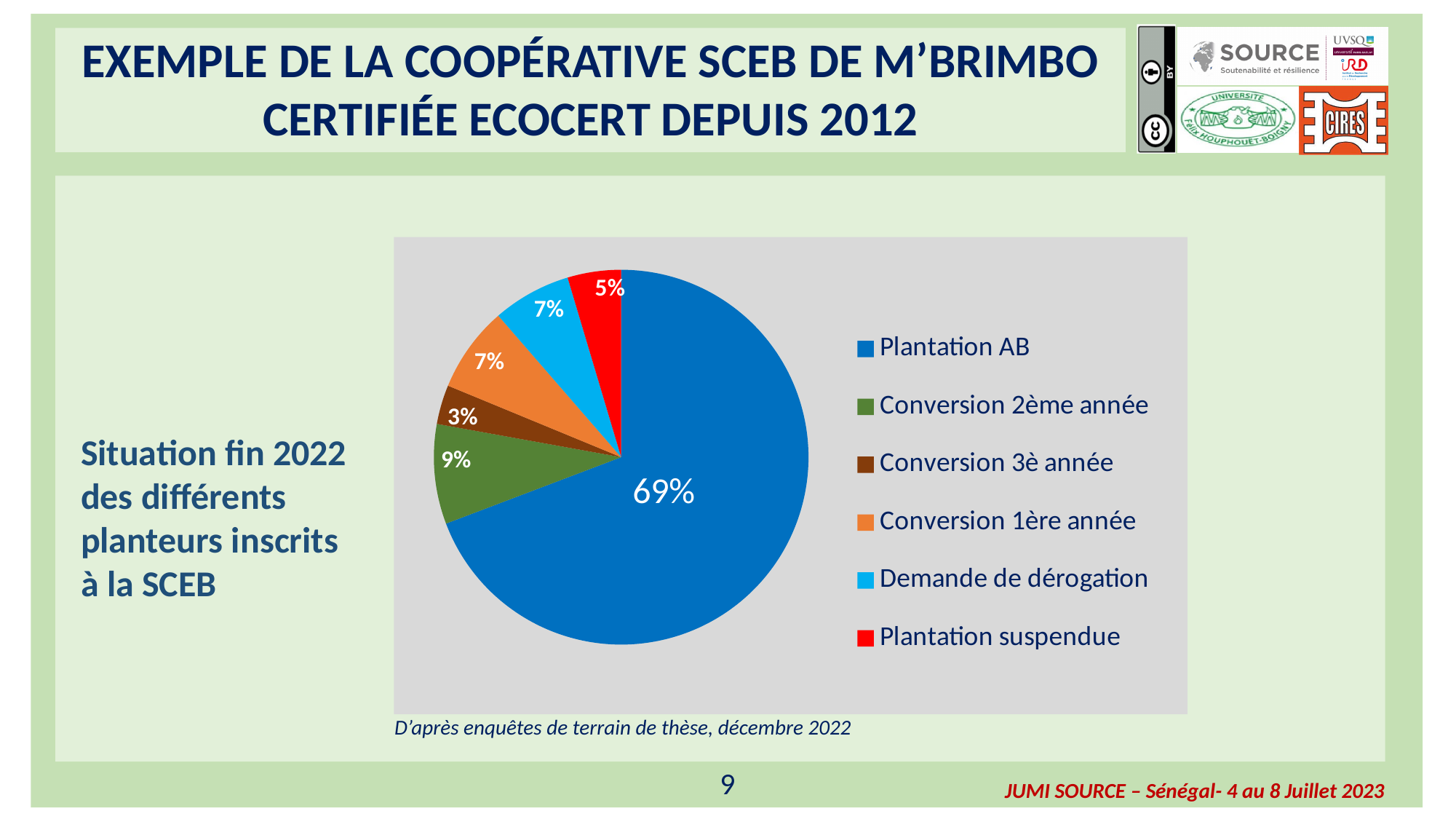
What share of the pie does Plantation suspendue represent? 5% What colour is the slice for Plantation suspendue? red What share of the pie does Demande de dérogation represent? 7% What type of chart is shown on the slide? pie chart What share of the pie does Plantation AB represent? 69% Which category has the smallest slice of the pie? Conversion 3è année Which is larger, the share for Conversion 2ème année or the share for Plantation suspendue? Conversion 2ème année Which category has the largest slice of the pie? Plantation AB What is the difference in percentage points between Plantation AB and Conversion 2ème année? 60 How many categories does the pie chart legend list? 6